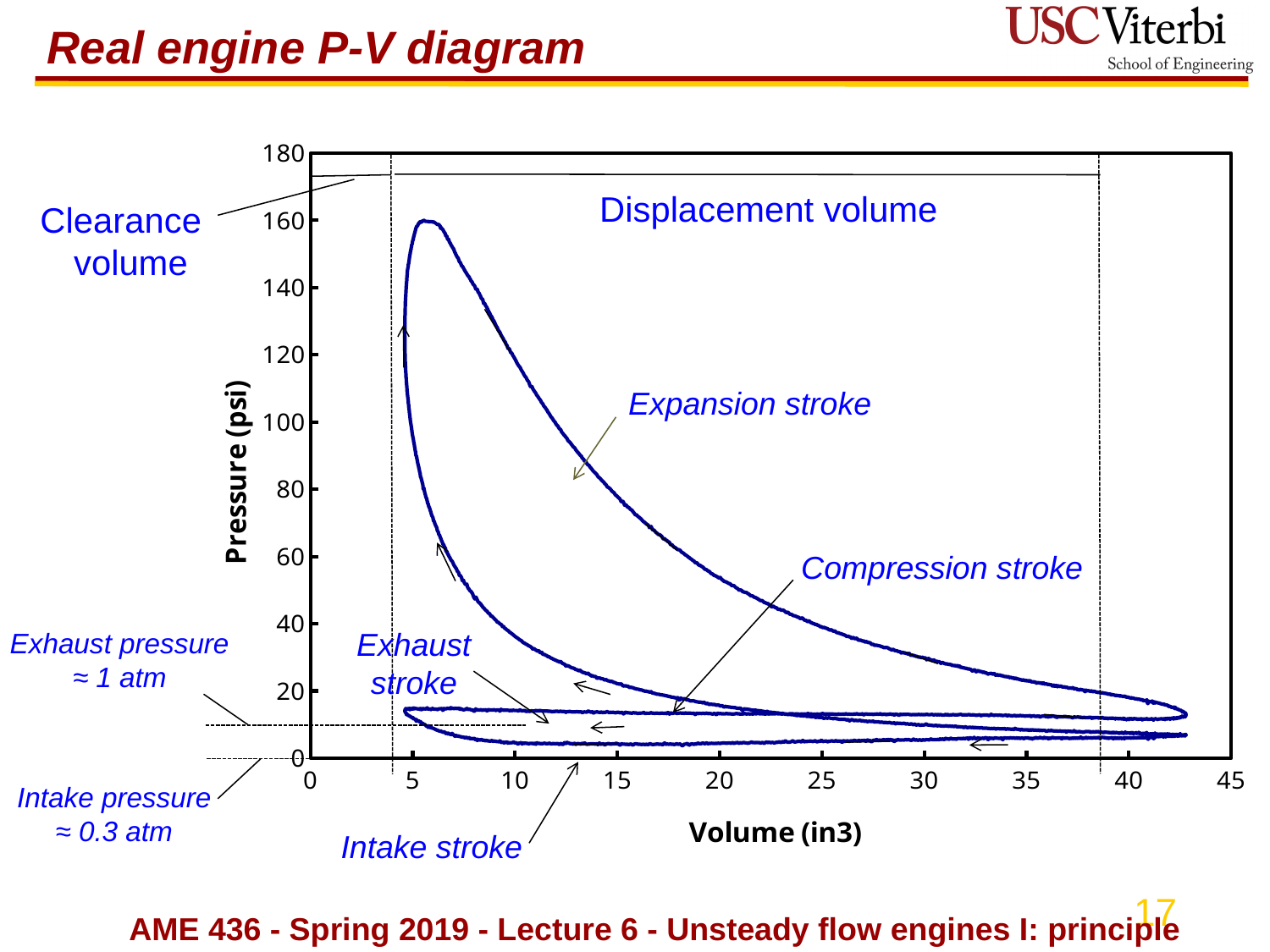
Is the largest volume reached in the cycle greater or less than 40 in3? greater Which stroke reaches a higher pressure at a volume of 20 in3, the expansion stroke or the compression stroke? Expansion stroke What kind of chart is shown on the slide? line chart Is the volume at which the peak pressure occurs greater or less than 10 in3? less Is the peak pressure reached in the cycle greater or less than 180 psi? less How many engine strokes are labelled on the P-V diagram? 4 What quantity is plotted on the horizontal axis of the P-V diagram? Volume (in3) Along the expansion stroke, does the pressure rise or fall as the volume increases? fall What quantity is plotted on the vertical axis of the P-V diagram? Pressure (psi)